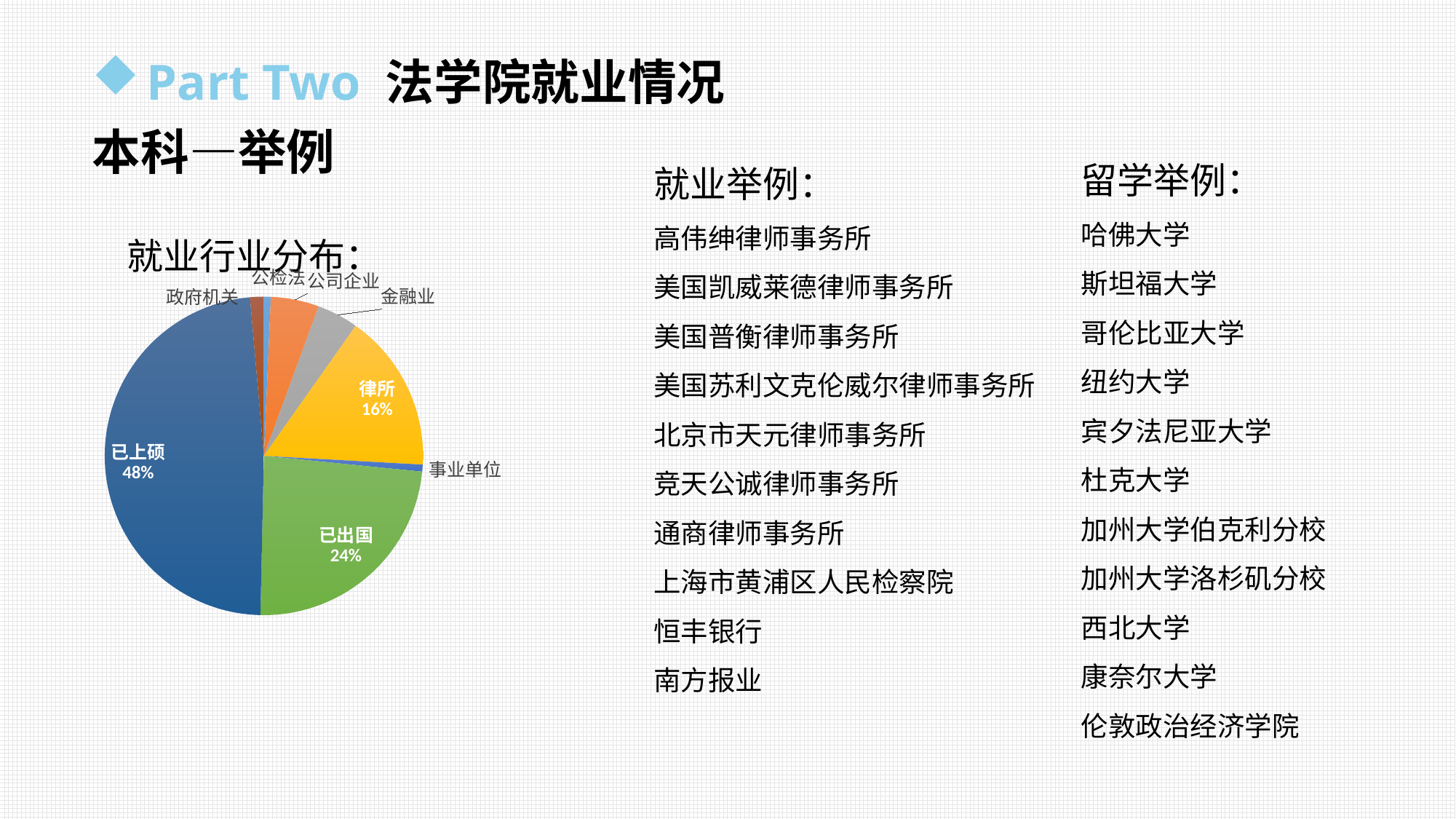
Which category has the largest slice of the pie chart? 已上硕 What colour is the 已上硕 slice of the pie chart? blue What is the difference in percentage points between 已出国 and 律所? 8 What percentage of the pie chart is labelled 已上硕? 48% How many slices does the pie chart have? 8 What share of the pie does 已出国 account for? 24% Which is larger, the 已出国 slice or the 律所 slice? 已出国 What is the value shown for the 律所 slice? 16% What is the title of the pie chart? 就业行业分布 What type of chart is shown on the slide? pie chart What is the difference in percentage points between 已上硕 and 已出国? 24